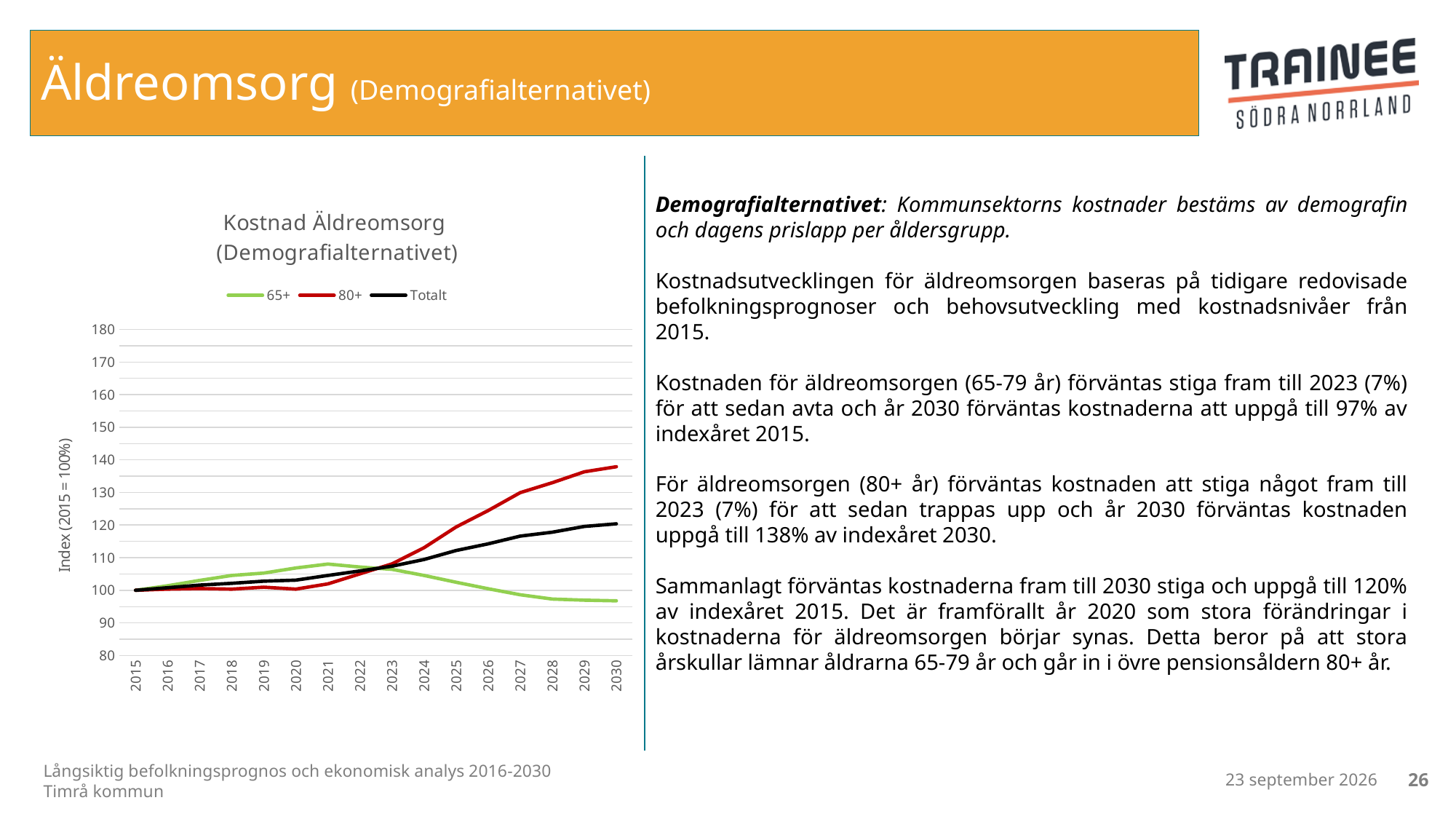
In 2021, which series has the larger value, 65+ or 80+? 65+ Is the value for Totalt in 2030 greater or less than 110? greater How many series does the chart legend list? 3 Which series has the lowest value in 2030? 65+ Which series has the highest value in 2030? 80+ What is the index value for Totalt in 2015? 100 Is the value for 80+ in 2030 greater or less than 130? greater What is the label on the y axis of the chart? Index (2015 = 100%) How many years are plotted along the x axis of the chart? 16 Is the value for 65+ in 2030 greater or less than 100? less What kind of chart is shown on the slide? Line chart Does the 80+ series rise or fall between 2021 and 2030? Rise